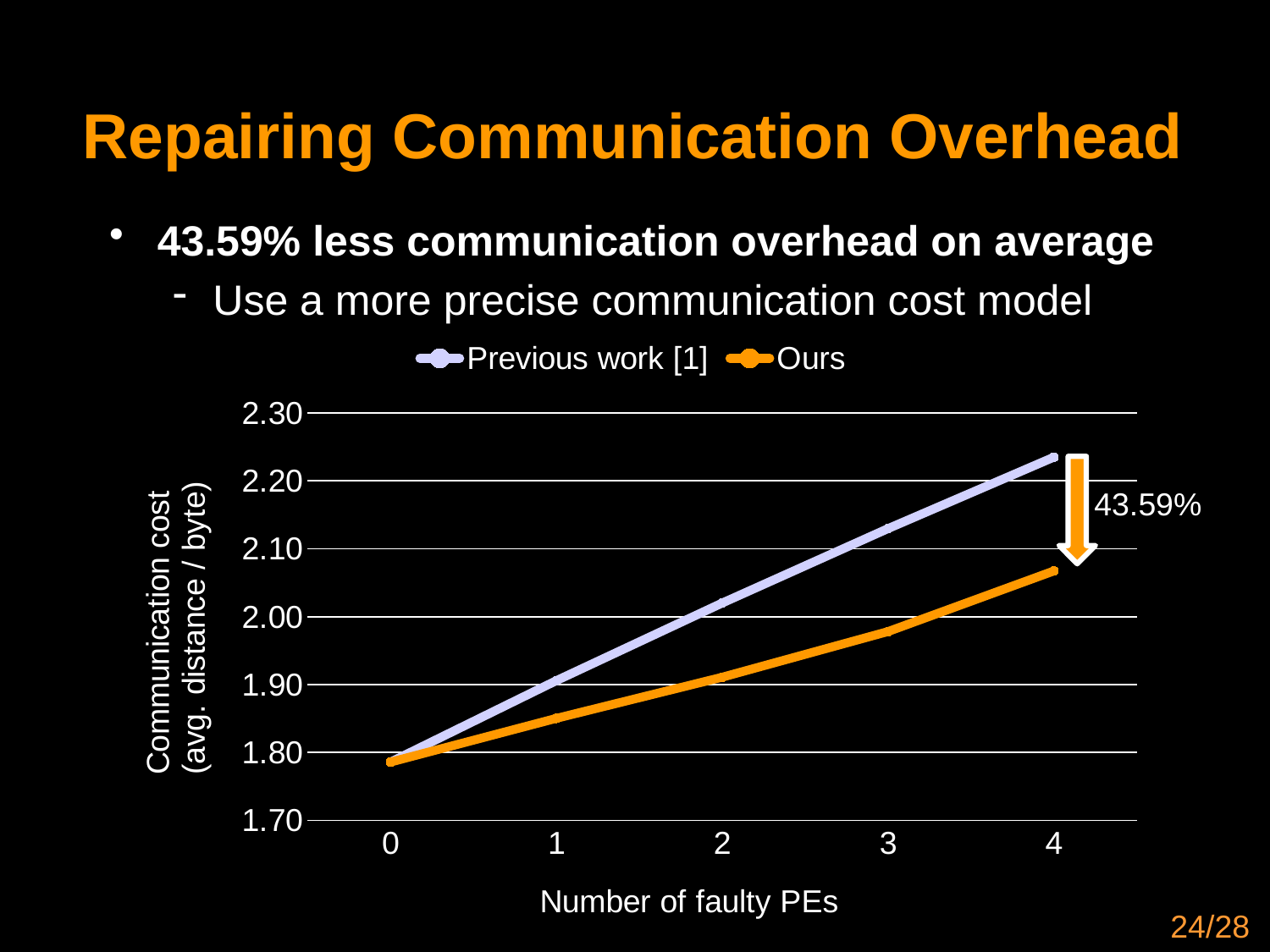
How many values of Number of faulty PEs are plotted on the x axis? 5 Is the communication cost for Ours at 1 faulty PE greater or less than 1.90? less Do the communication cost values for Ours rise or fall as the number of faulty PEs increases? rise Is the communication cost for Ours at 4 faulty PEs greater or less than 2.10? less Is the communication cost for Previous work [1] at 4 faulty PEs greater or less than 2.20? greater What percentage reduction is annotated next to the arrow at 4 faulty PEs? 43.59% What kind of chart is shown on the slide? line chart At 2 faulty PEs, which series has the lower communication cost, Previous work [1] or Ours? Ours What is the title of the x axis of the chart? Number of faulty PEs How many series does the chart legend list? 2 At 4 faulty PEs, which series has the higher communication cost, Previous work [1] or Ours? Previous work [1]